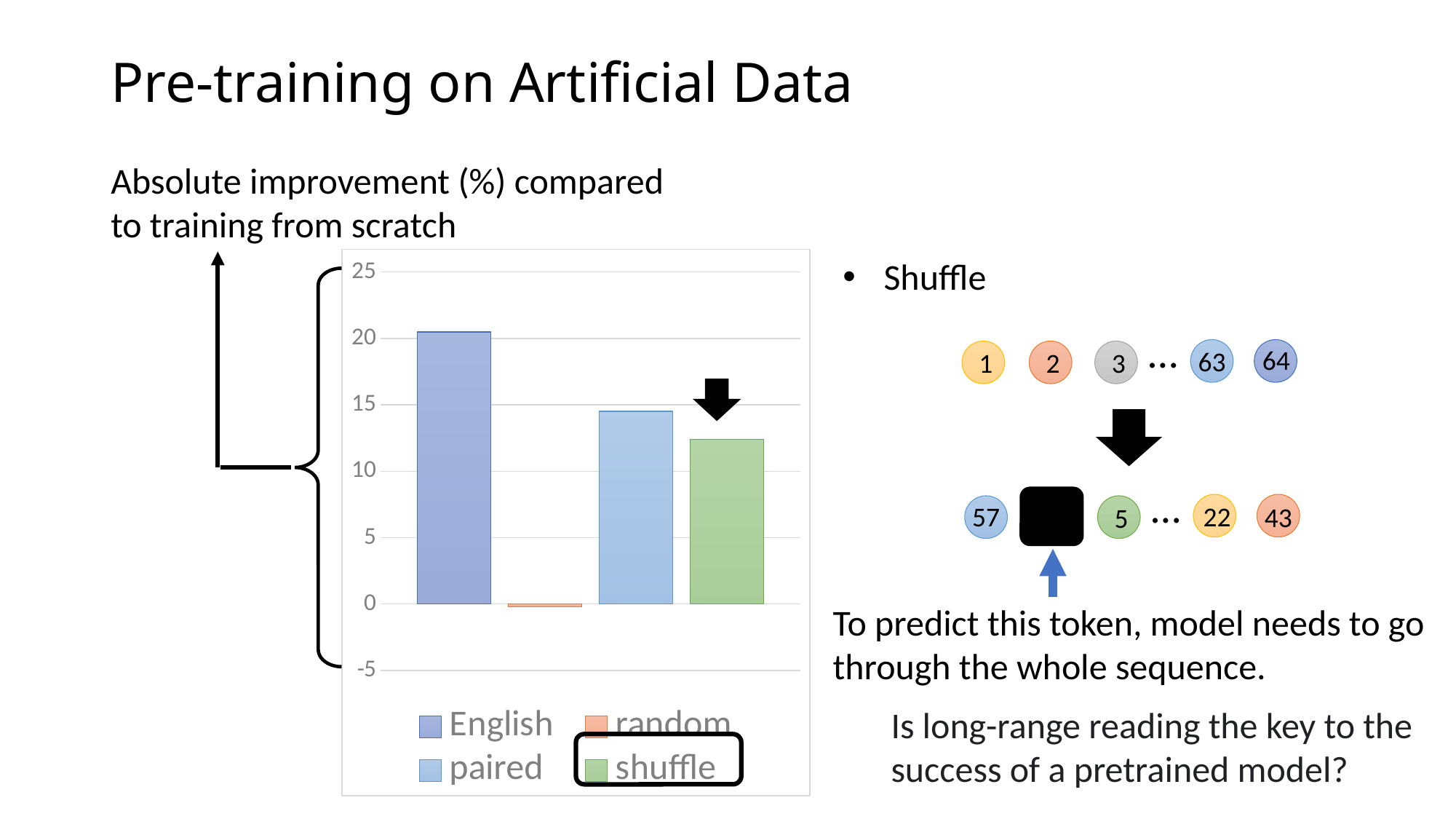
How many series does the chart legend list? 4 Is the value for shuffle greater or less than 10? greater How many bars are plotted in the chart? 4 Which is larger, the value for paired or the value for shuffle? paired Is the value for random greater or less than 5? less Which is larger, the value for English or the value for paired? English Which legend entry is highlighted with a black box? shuffle Is the value for English greater or less than 15? greater Which series has the highest value in the chart? English What kind of chart is shown on the slide? bar chart Which series has the lowest value in the chart? random